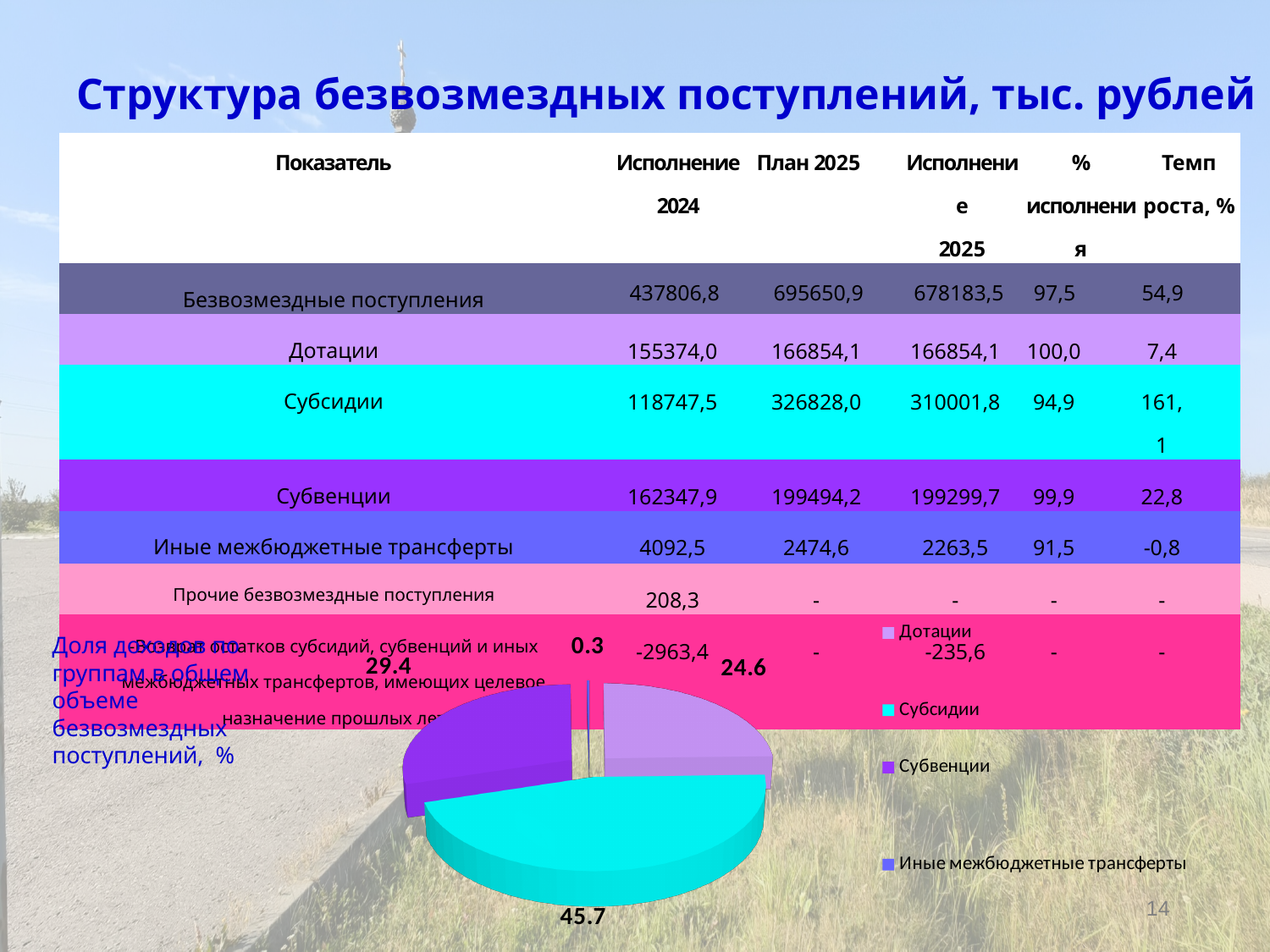
What is the value shown for Субсидии in the pie chart? 45.7 How many series does the pie chart legend list? 4 What colour is the Субсидии slice in the pie chart? cyan Which category has the largest slice in the pie chart? Субсидии What is the difference between the pie chart values for Субсидии and Субвенции? 16.3 In the pie chart, which is larger: Субвенции or Дотации? Субвенции What is the value shown for Иные межбюджетные трансферты in the pie chart? 0.3 What is the value shown for Дотации in the pie chart? 24.6 What kind of chart is shown on the slide? pie chart Which category has the smallest slice in the pie chart? Иные межбюджетные трансферты What is the difference between the pie chart values for Субвенции and Дотации? 4.8 What is the value shown for Субвенции in the pie chart? 29.4